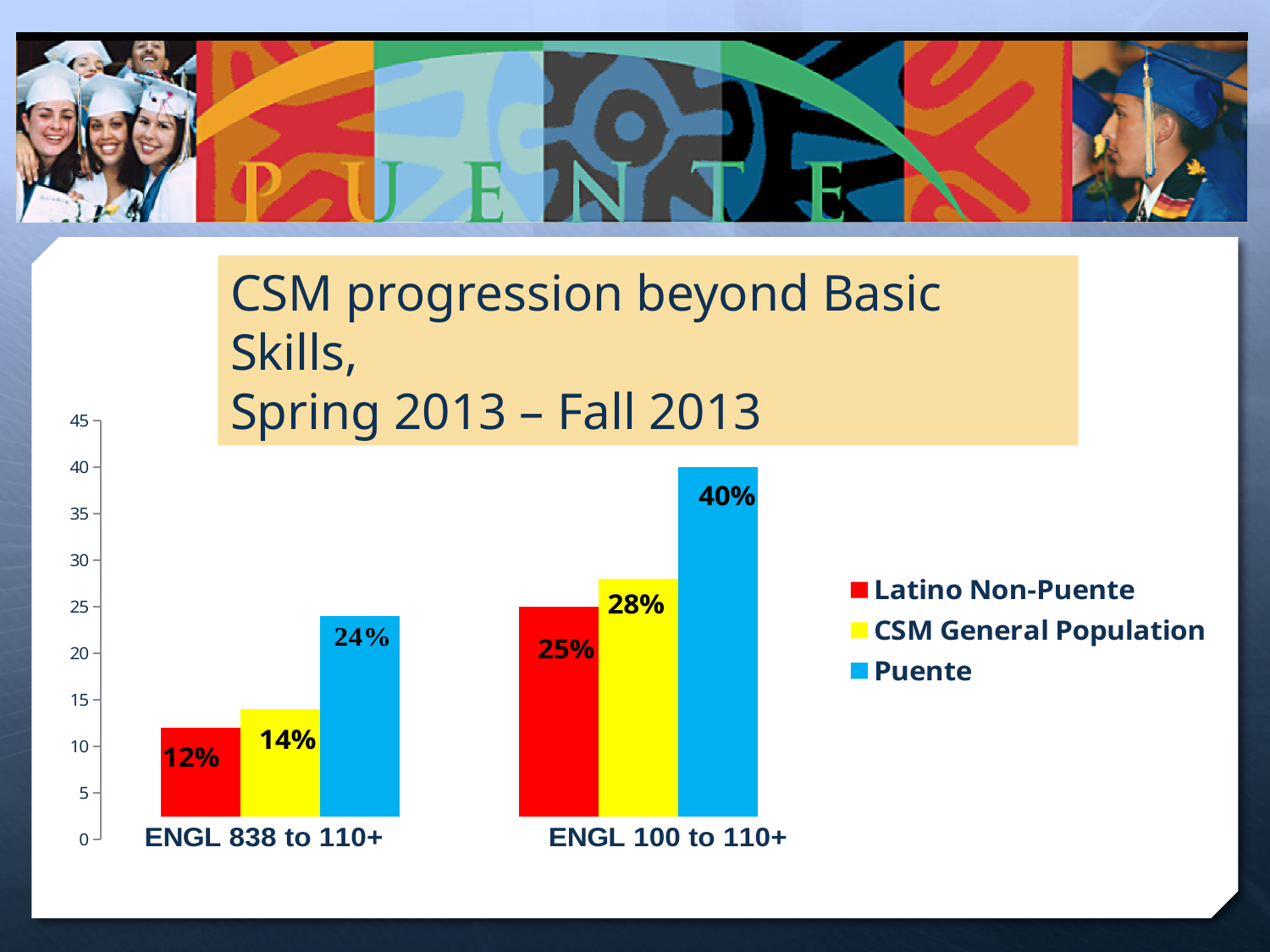
What is the difference between the Puente values for ENGL 100 to 110+ and ENGL 838 to 110+? 16% What colour represents the Puente series in the chart? Blue Which is larger: CSM General Population for ENGL 838 to 110+ or Latino Non-Puente for ENGL 100 to 110+? Latino Non-Puente for ENGL 100 to 110+ Which series has the highest value in the ENGL 838 to 110+ category? Puente What kind of chart is shown on the slide? Bar chart How many categories are shown on the x axis? 2 What is the value for CSM General Population in the ENGL 100 to 110+ category? 28% How many series does the legend list? 3 What is the value for Puente in the ENGL 100 to 110+ category? 40% What is the value for Latino Non-Puente in the ENGL 838 to 110+ category? 12% Which series has the lowest value in the ENGL 100 to 110+ category? Latino Non-Puente What is the difference between the Puente and Latino Non-Puente values in the ENGL 100 to 110+ category? 15%